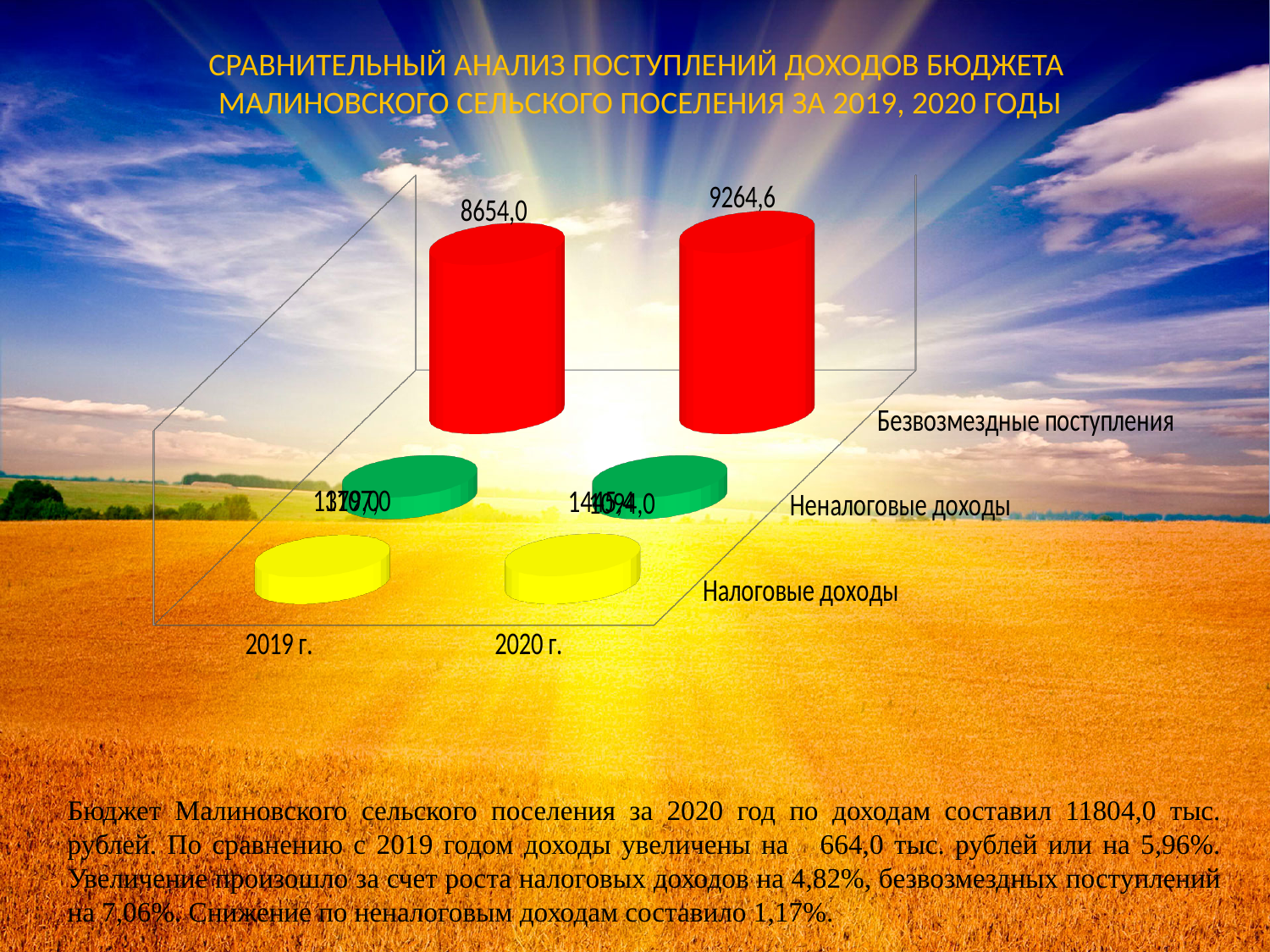
What kind of chart is shown on the slide? Bar chart What is the difference between the Безвозмездные поступления values for 2020 г. and 2019 г.? 610,6 Does the value for Безвозмездные поступления rise or fall from 2019 г. to 2020 г.? Rise How many series are plotted on the chart? 3 Which year has the larger value for Безвозмездные поступления, 2019 г. or 2020 г.? 2020 г. Which series has the highest value in 2019 г.? Безвозмездные поступления What colour are the bars for Налоговые доходы? Yellow What colour are the bars for Безвозмездные поступления? Red What is the value for Безвозмездные поступления in 2019 г.? 8654,0 What is the value for Безвозмездные поступления in 2020 г.? 9264,6 How many years (categories) are shown on the chart's x axis? 2